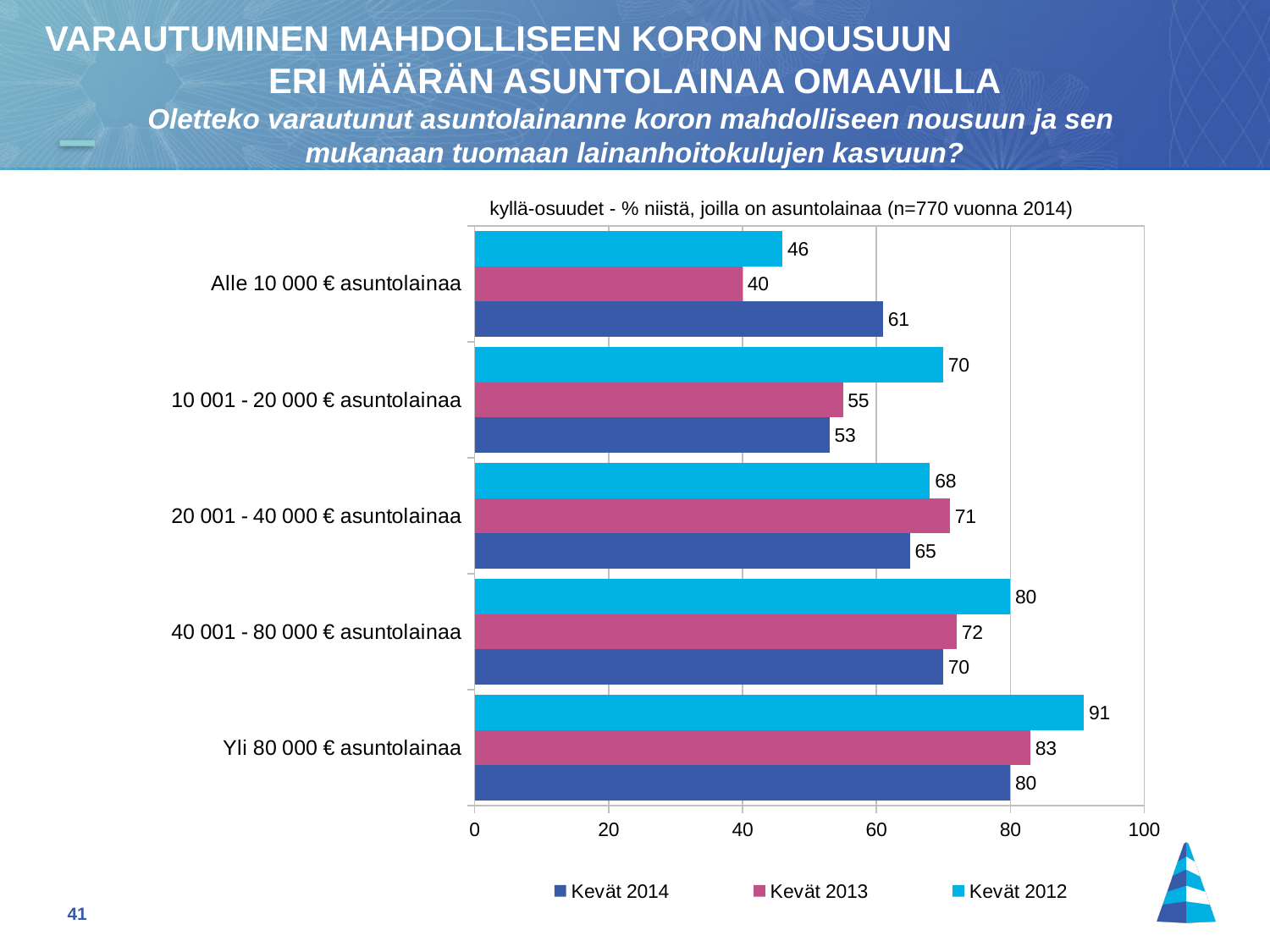
Which category has the lowest Kevät 2012 value? Alle 10 000 € asuntolainaa What is the Kevät 2013 value for 10 001 - 20 000 € asuntolainaa? 55 How many loan-size categories are shown on the chart? 5 What is the difference between the Kevät 2012 and Kevät 2013 values for Alle 10 000 € asuntolainaa? 6 Is the Kevät 2014 value for 40 001 - 80 000 € asuntolainaa greater or less than 60? greater Which category has the highest Kevät 2013 value? Yli 80 000 € asuntolainaa What kind of chart is shown on the slide? Bar chart What is the Kevät 2014 value for Alle 10 000 € asuntolainaa? 61 Which series is shown in pink in the legend? Kevät 2013 For 20 001 - 40 000 € asuntolainaa, which series has the larger value: Kevät 2013 or Kevät 2014? Kevät 2013 What is the Kevät 2012 value for Yli 80 000 € asuntolainaa? 91 How many series does the legend list? 3